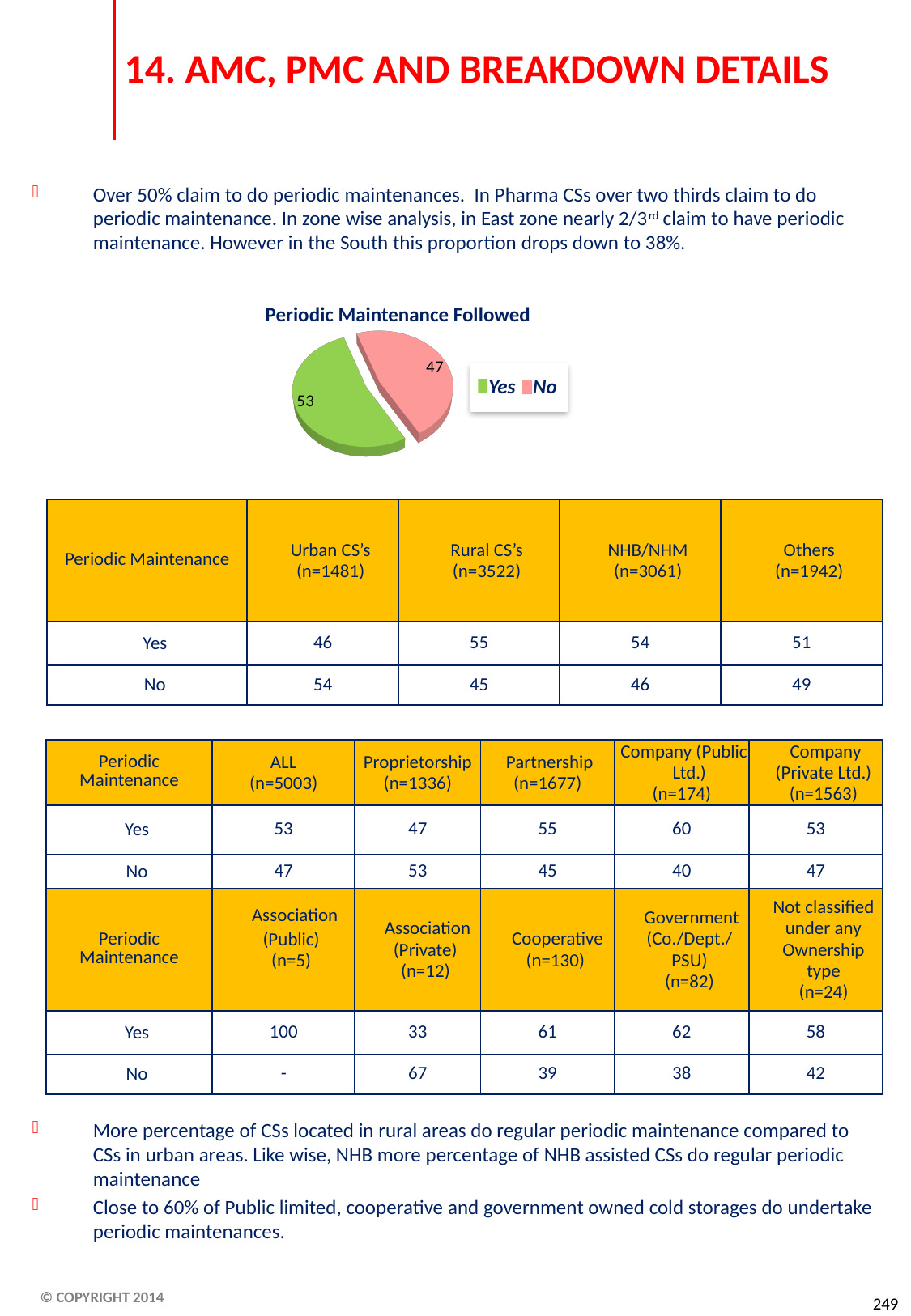
What is the value for No in the Periodic Maintenance Followed pie chart? 47 In the Periodic Maintenance Followed pie chart, which is larger, Yes or No? Yes How many entries does the legend of the Periodic Maintenance Followed pie chart list? 2 What kind of chart is shown under the heading Periodic Maintenance Followed? Pie chart What is the total of the two values shown in the Periodic Maintenance Followed pie chart? 100 What is the title of the chart on the slide? Periodic Maintenance Followed Which slice of the Periodic Maintenance Followed pie chart is the smallest? No What colour is the Yes slice in the Periodic Maintenance Followed pie chart? Green Which slice of the Periodic Maintenance Followed pie chart is the largest? Yes What is the difference between the Yes and No values in the Periodic Maintenance Followed pie chart? 6 What is the value for Yes in the Periodic Maintenance Followed pie chart? 53 How many slices does the Periodic Maintenance Followed pie chart have? 2